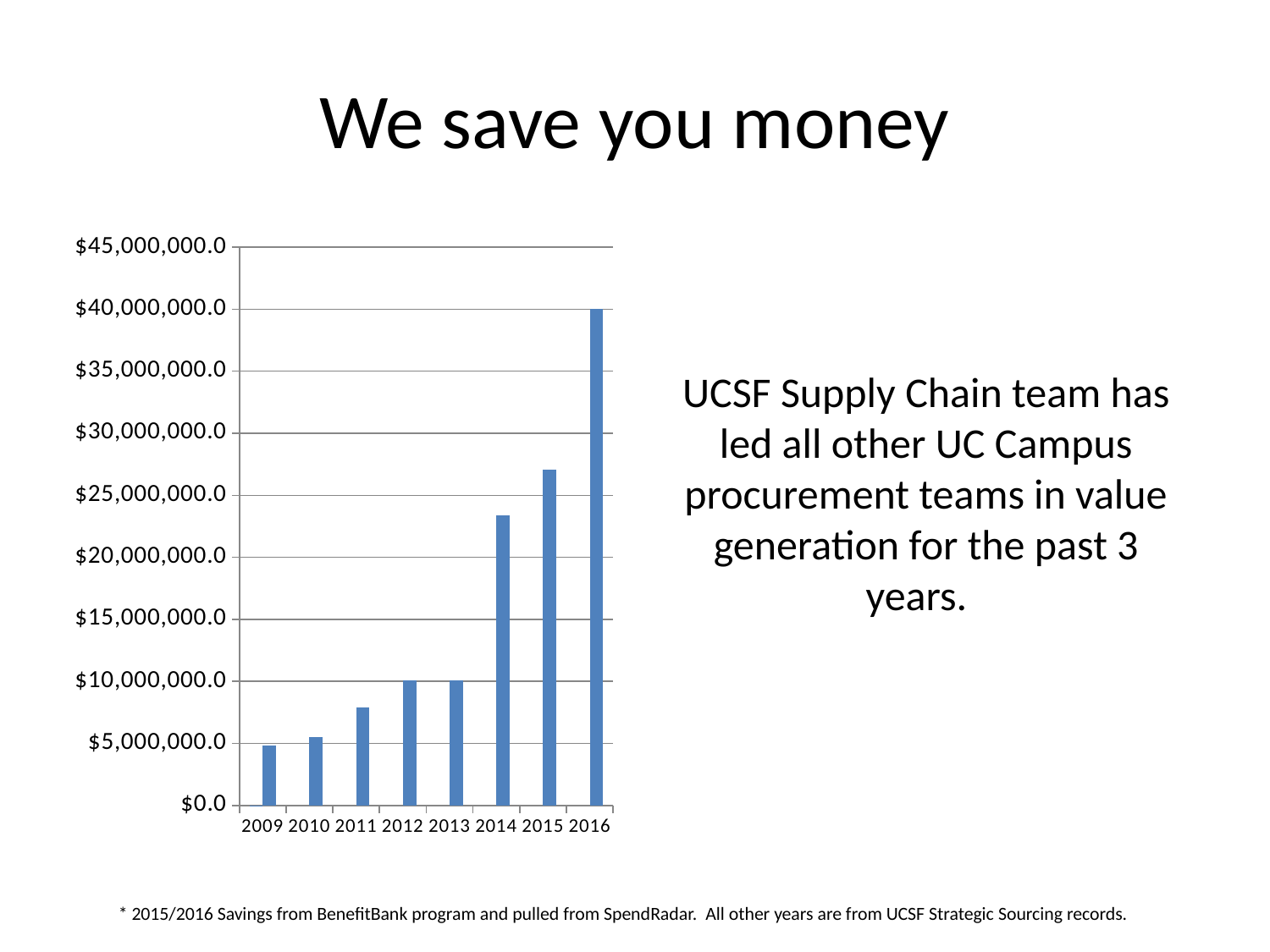
Do the values generally rise or fall from 2009 to 2016? rise Is the value for 2016 greater or less than $35,000,000.0? greater What is the title of the slide containing the chart? We save you money Which year has the highest bar on the chart? 2016 What kind of chart is shown on the slide? bar chart How many years are plotted on the chart? 8 Is the value for 2015 greater or less than $25,000,000.0? greater Which year has the larger value, 2011 or 2013? 2013 Is the value for 2011 greater or less than $10,000,000.0? less Which year has the lowest bar on the chart? 2009 Which year has the larger value, 2014 or 2015? 2015